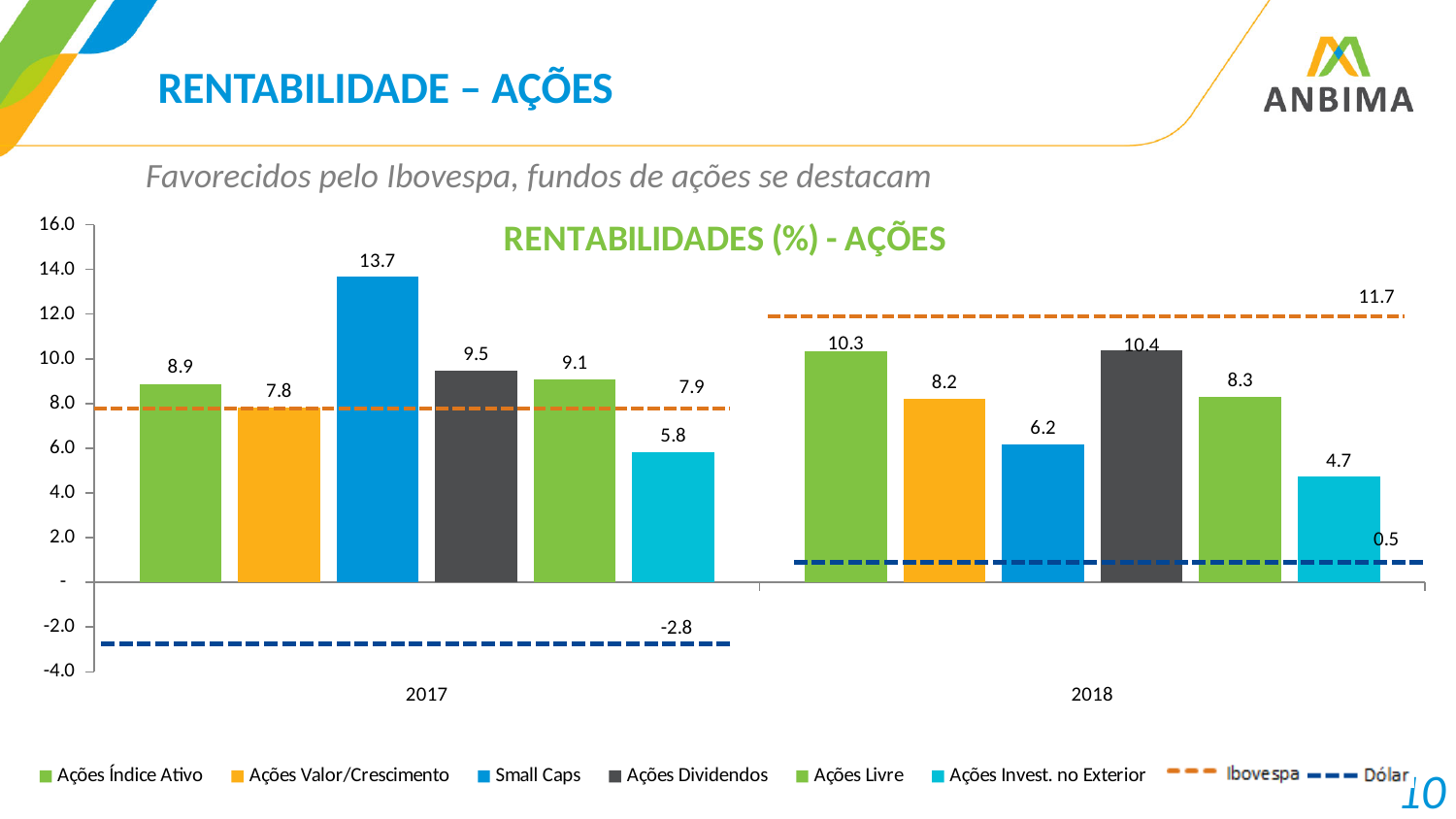
Which is larger: Ações Índice Ativo in 2017 or Ações Índice Ativo in 2018? Ações Índice Ativo in 2018 What kind of chart is shown on the slide? Combination bar and line chart How many year groups are shown on the x axis? 2 What is the Ibovespa value shown for 2018? 11.7 Which series has the lowest value in 2018? Dólar How many series does the legend list? 8 What is the Dólar value shown for 2017? -2.8 What is the value for Small Caps in 2017? 13.7 What is the title of the chart? RENTABILIDADES (%) - AÇÕES What is the difference between the Small Caps values for 2017 and 2018? 7.5 What is the value for Ações Dividendos in 2018? 10.4 Which series has the highest value in 2017? Small Caps